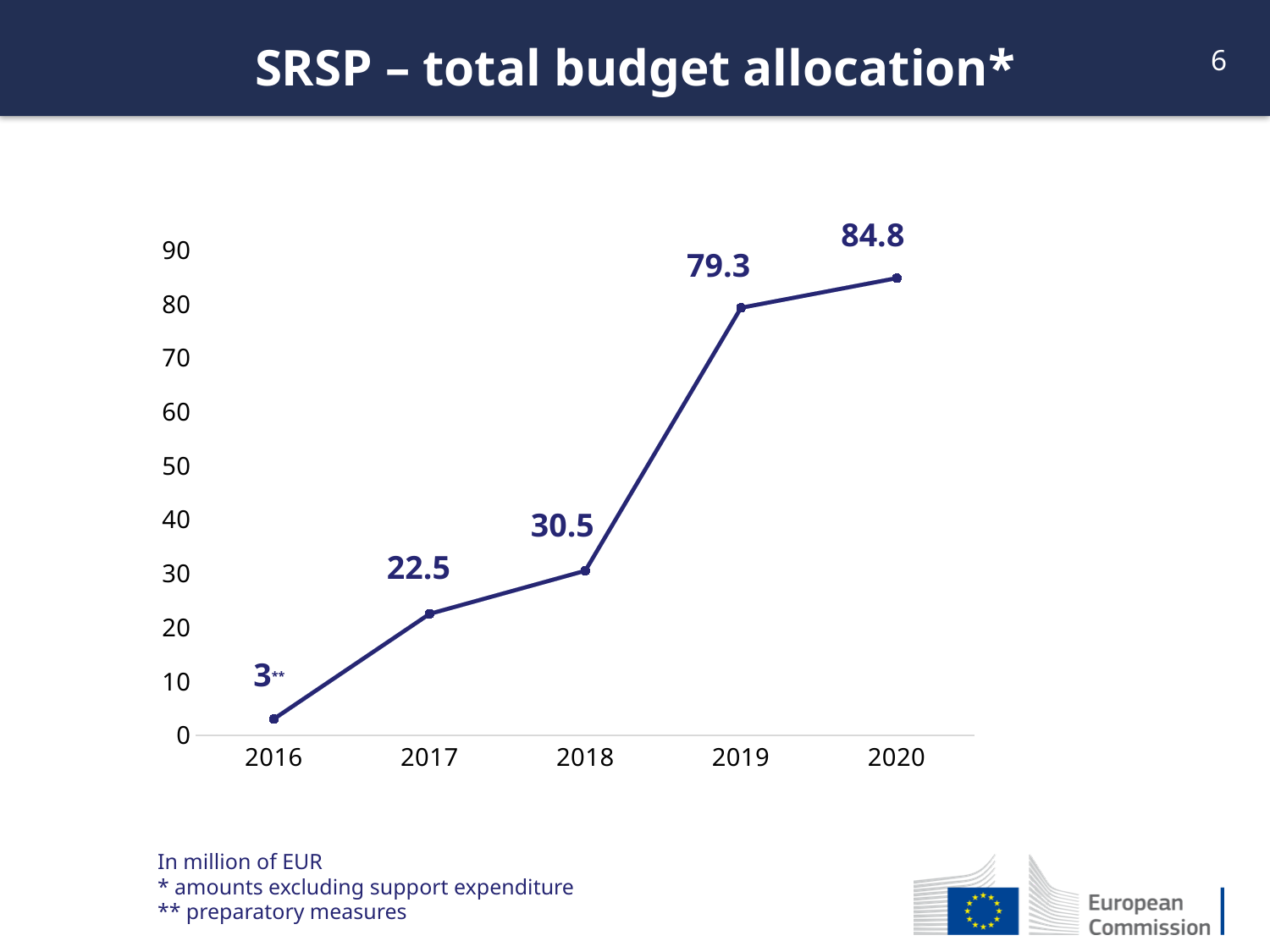
Do the values rise or fall from 2016 to 2020? rise What is the difference between the 2020 and 2019 budget allocations? 5.5 Which year has a larger budget allocation, 2017 or 2018? 2018 What is the total budget allocation for 2016? 3 What is the total budget allocation for 2018? 30.5 What kind of chart is shown on the slide? line chart Is the value for 2019 greater or less than 70? greater What is the difference between the 2019 and 2018 budget allocations? 48.8 What is the total budget allocation for 2020? 84.8 Which year has the lowest budget allocation? 2016 How many years are plotted on the chart? 5 Which year has the highest budget allocation? 2020